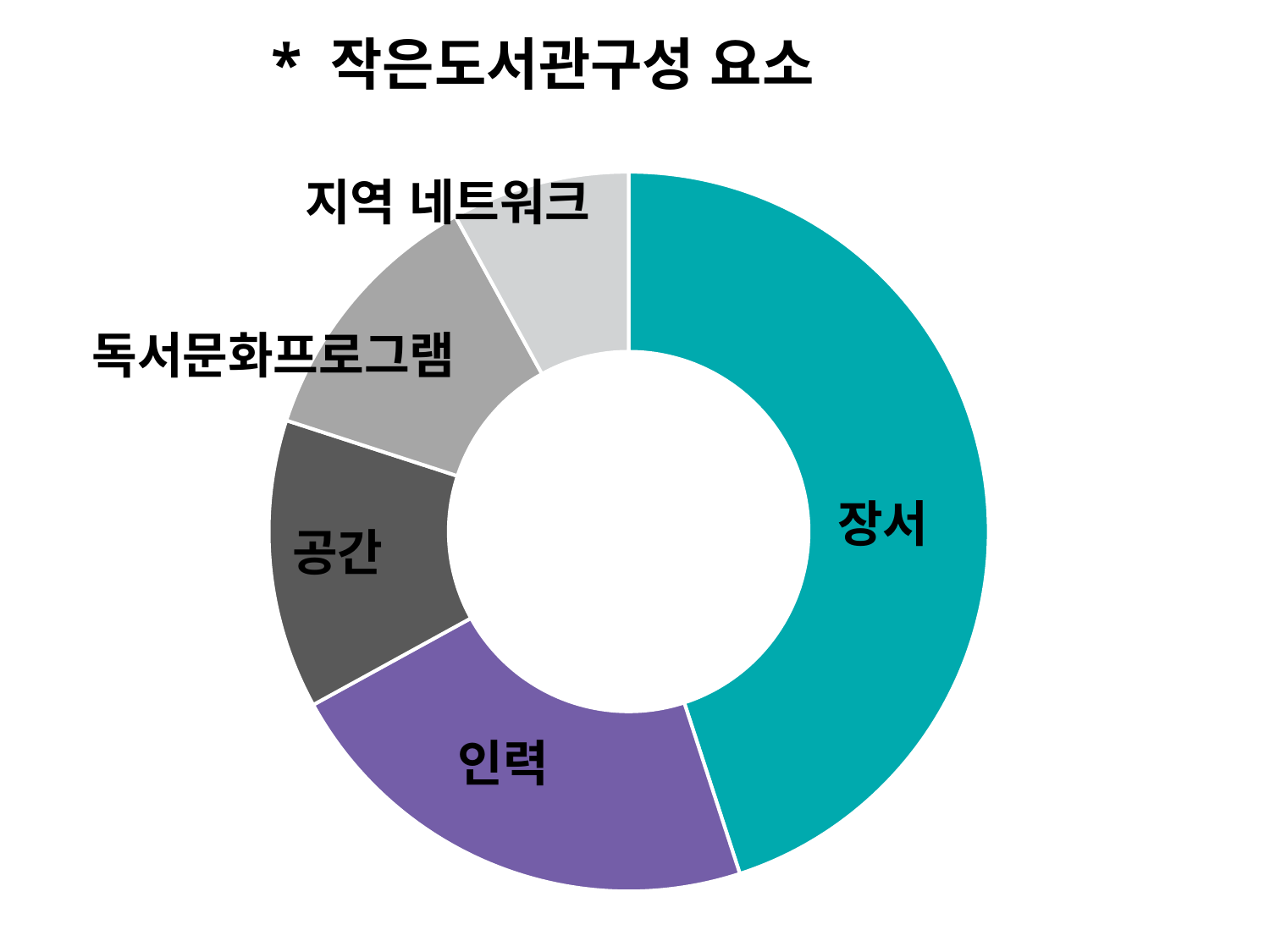
What kind of chart is shown on the slide? Doughnut (pie) chart Which slice is larger, 인력 or 지역 네트워크? 인력 What colour is the 장서 slice? Teal Which slice is larger, 공간 or 장서? 장서 Which slice is larger, 지역 네트워크 or 독서문화프로그램? 독서문화프로그램 Which category has the largest slice in the chart? 장서 What is the title of the chart? * 작은도서관구성 요소 How many categories (slices) does the chart have? 5 Which category has the smallest slice in the chart? 지역 네트워크